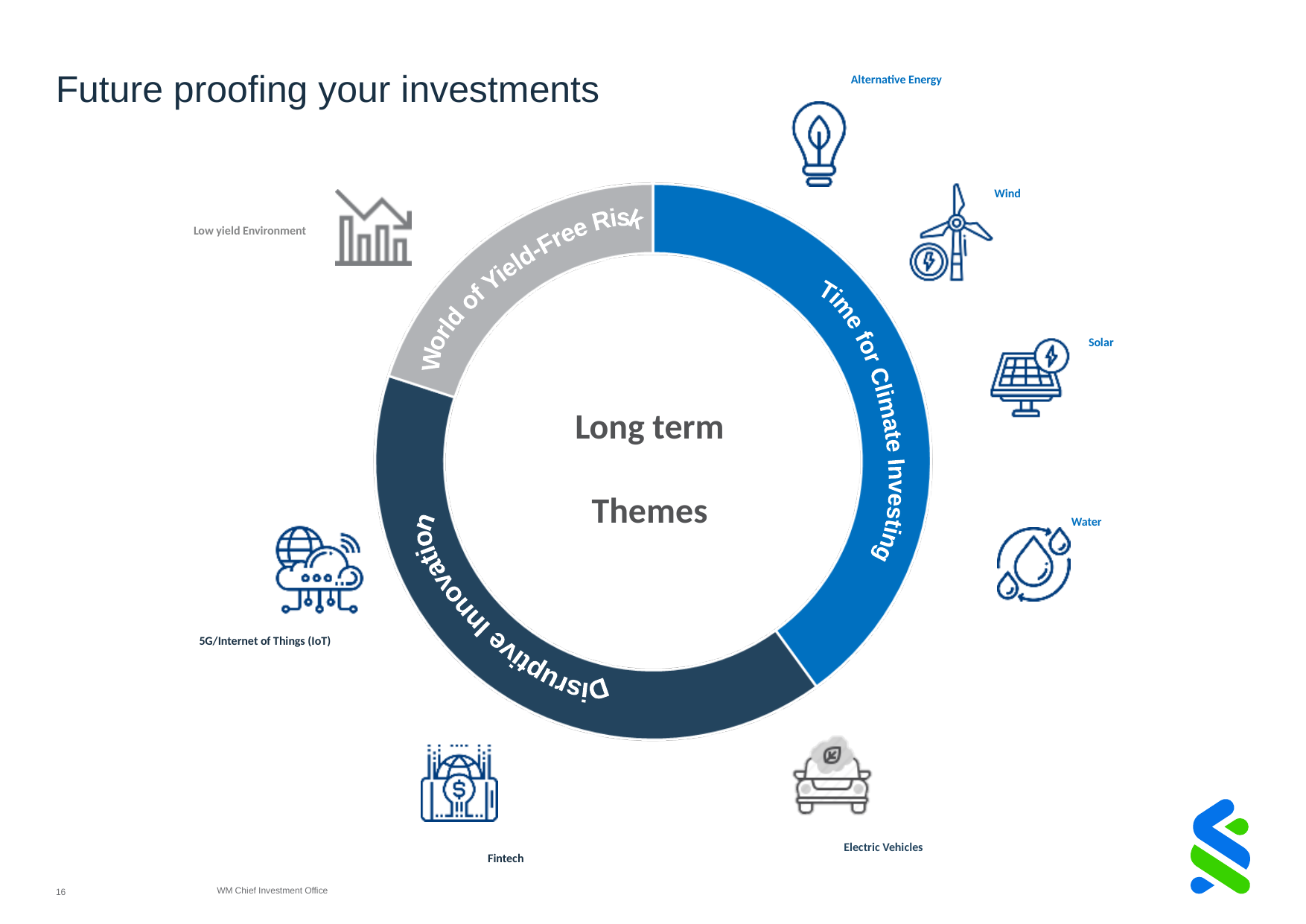
Which segment of the donut chart is the smallest? World of Yield-Free Risk What kind of chart is shown in the centre of the slide? Donut chart How many segments does the donut chart have? 3 Which is larger in the donut chart: the World of Yield-Free Risk segment or the Time for Climate Investing segment? Time for Climate Investing What text appears in the centre of the donut chart? Long term Themes What colour is the World of Yield-Free Risk segment of the donut chart? Grey Which is larger in the donut chart: the Disruptive Innovation segment or the World of Yield-Free Risk segment? Disruptive Innovation